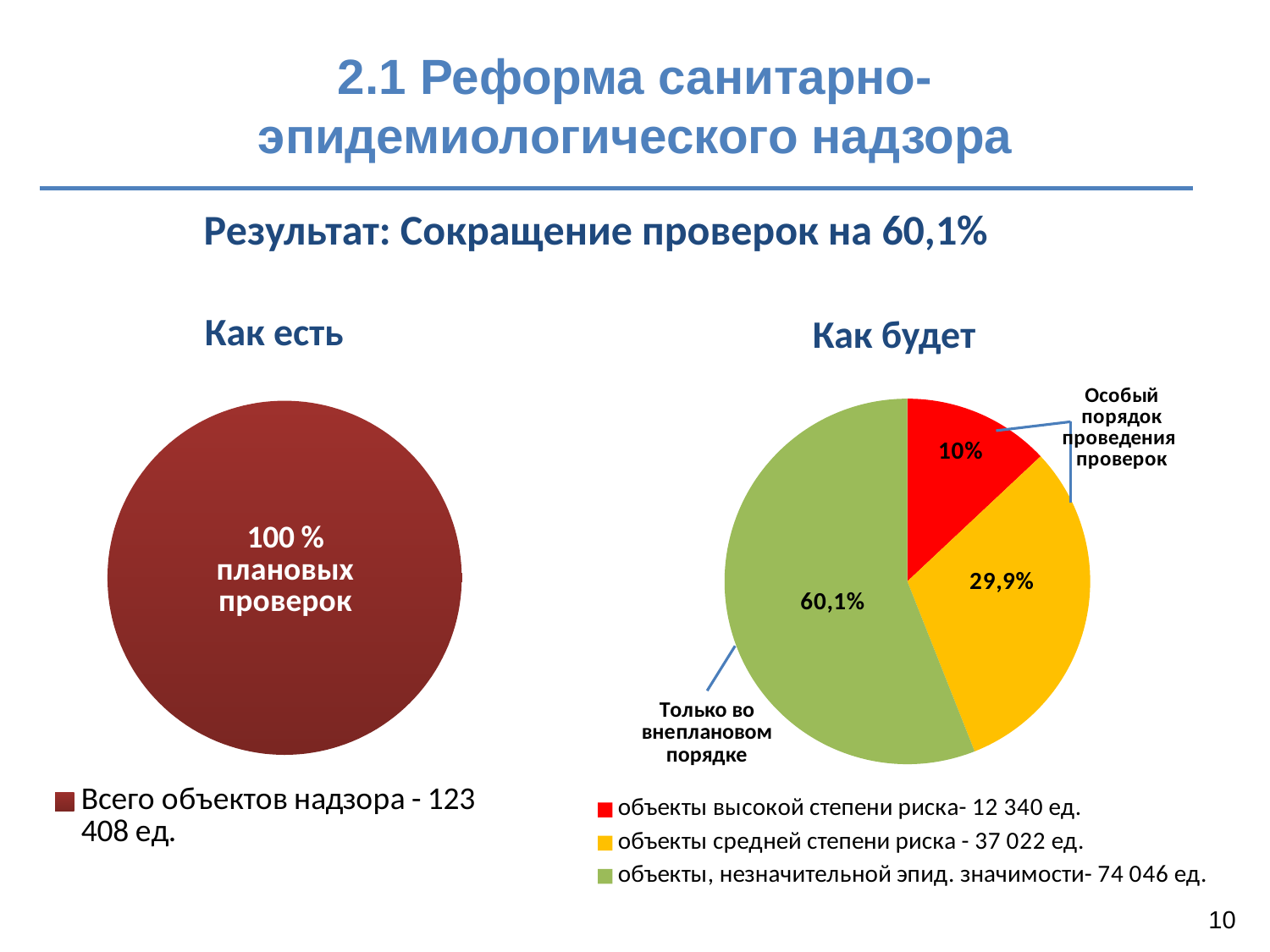
In the "Как будет" pie chart, what share is shown for the yellow slice (объекты средней степени риска)? 29,9% In the "Как будет" pie chart, what share is shown for the green slice (объекты, незначительной эпид. значимости)? 60,1% In the "Как будет" pie chart, which category has the smallest slice? объекты высокой степени риска What does the legend of the "Как есть" chart on the left say? Всего объектов надзора - 123 408 ед. In the "Как будет" pie chart, which is larger: the yellow slice (объекты средней степени риска) or the red slice (объекты высокой степени риска)? объекты средней степени риска In the "Как будет" pie chart, what share is shown for the red slice (объекты высокой степени риска)? 10% What kind of chart is the "Как будет" chart on the right? pie chart In the "Как будет" pie chart, which category has the largest slice? объекты, незначительной эпид. значимости How many slices does the "Как будет" pie chart have? 3 In the "Как будет" pie chart, what is the difference between the green slice (60,1%) and the yellow slice (29,9%)? 30,2% How many entries does the legend of the "Как будет" chart list? 3